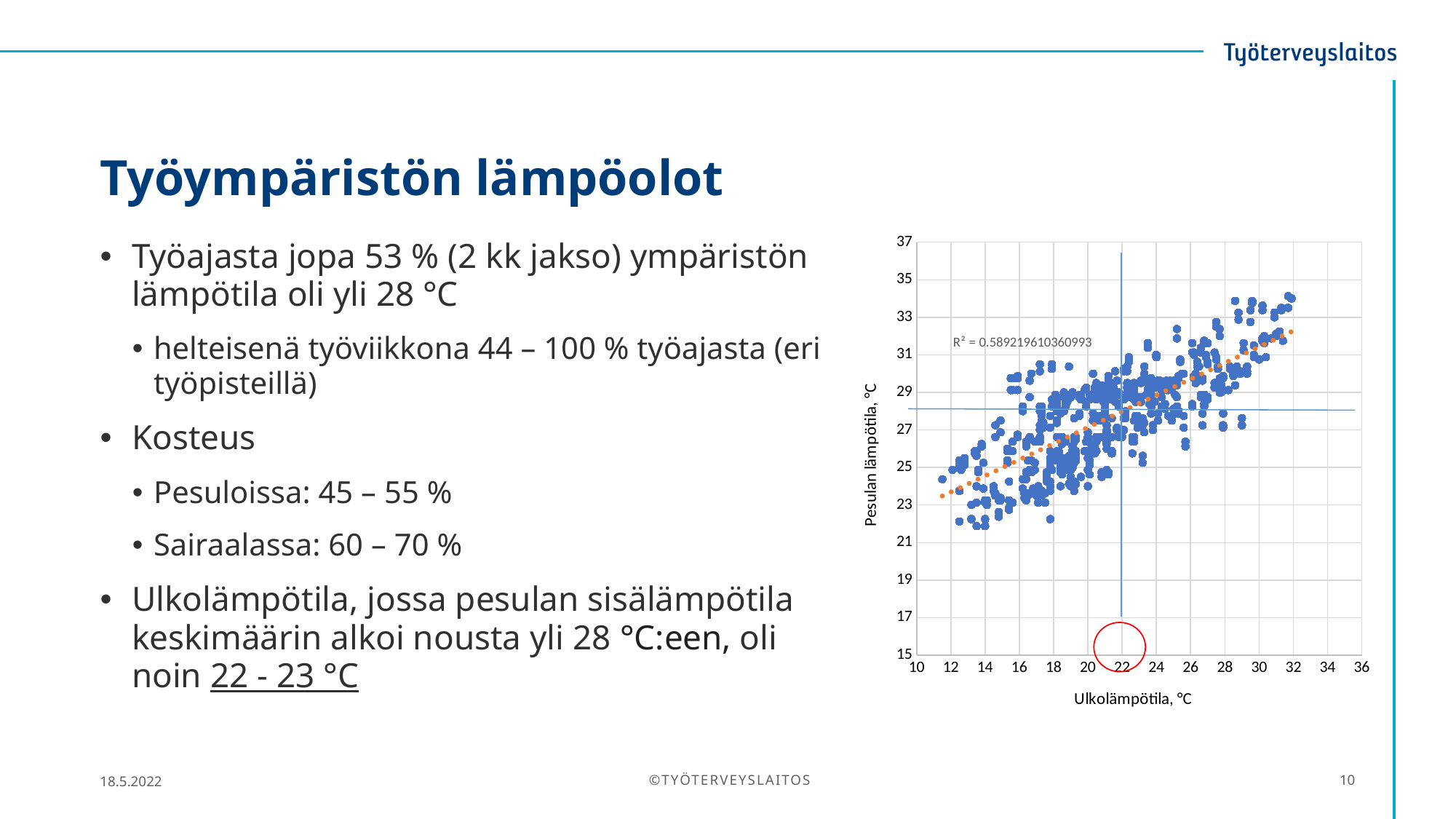
Do the plotted values of Pesulan lämpötila rise or fall as Ulkolämpötila increases along the x axis? rise Is the highest plotted Pesulan lämpötila value greater or less than 33? greater Is the highest plotted Ulkolämpötila value greater or less than 30? greater What R² value is printed on the chart? R² = 0.589219610360993 What is the title of the y axis of the chart? Pesulan lämpötila, °C Is the lowest plotted Pesulan lämpötila value greater or less than 25? less What kind of chart is shown on the slide? scatter chart What is the title of the x axis of the chart? Ulkolämpötila, °C